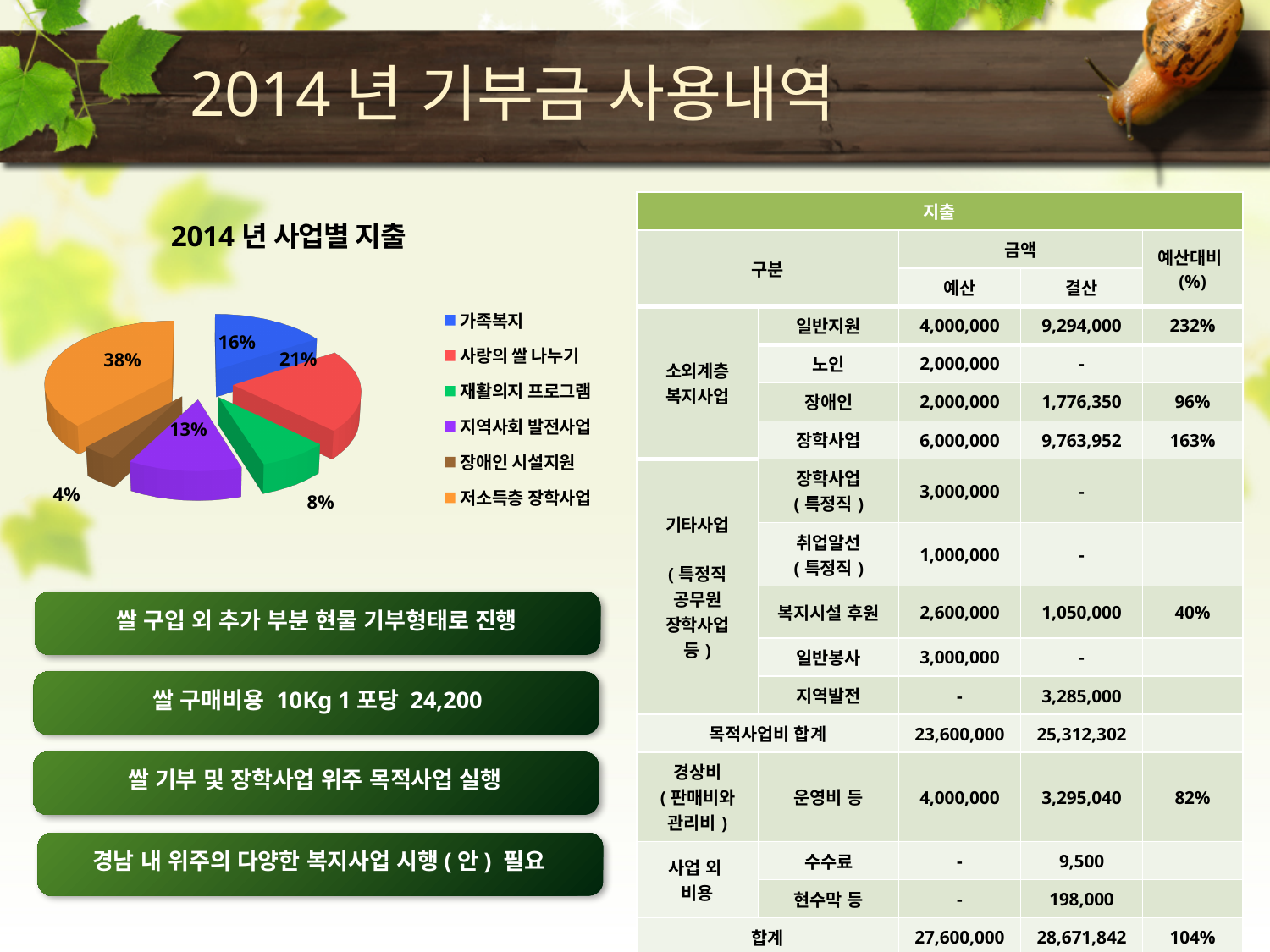
Which category has the largest slice of the pie? 저소득층 장학사업 What kind of chart is shown on the slide? pie chart What share of the pie does 사랑의 쌀 나누기 have? 21% What is the title of the chart? 2014 년 사업별 지출 What share of the pie does 가족복지 have? 16% Which is larger, the share for 재활의지 프로그램 or the share for 지역사회 발전사업? 지역사회 발전사업 What share of the pie does 지역사회 발전사업 have? 13% What is the difference in percentage points between 저소득층 장학사업 and 사랑의 쌀 나누기? 17% Which category has the smallest slice of the pie? 장애인 시설지원 How many categories does the legend of the pie chart list? 6